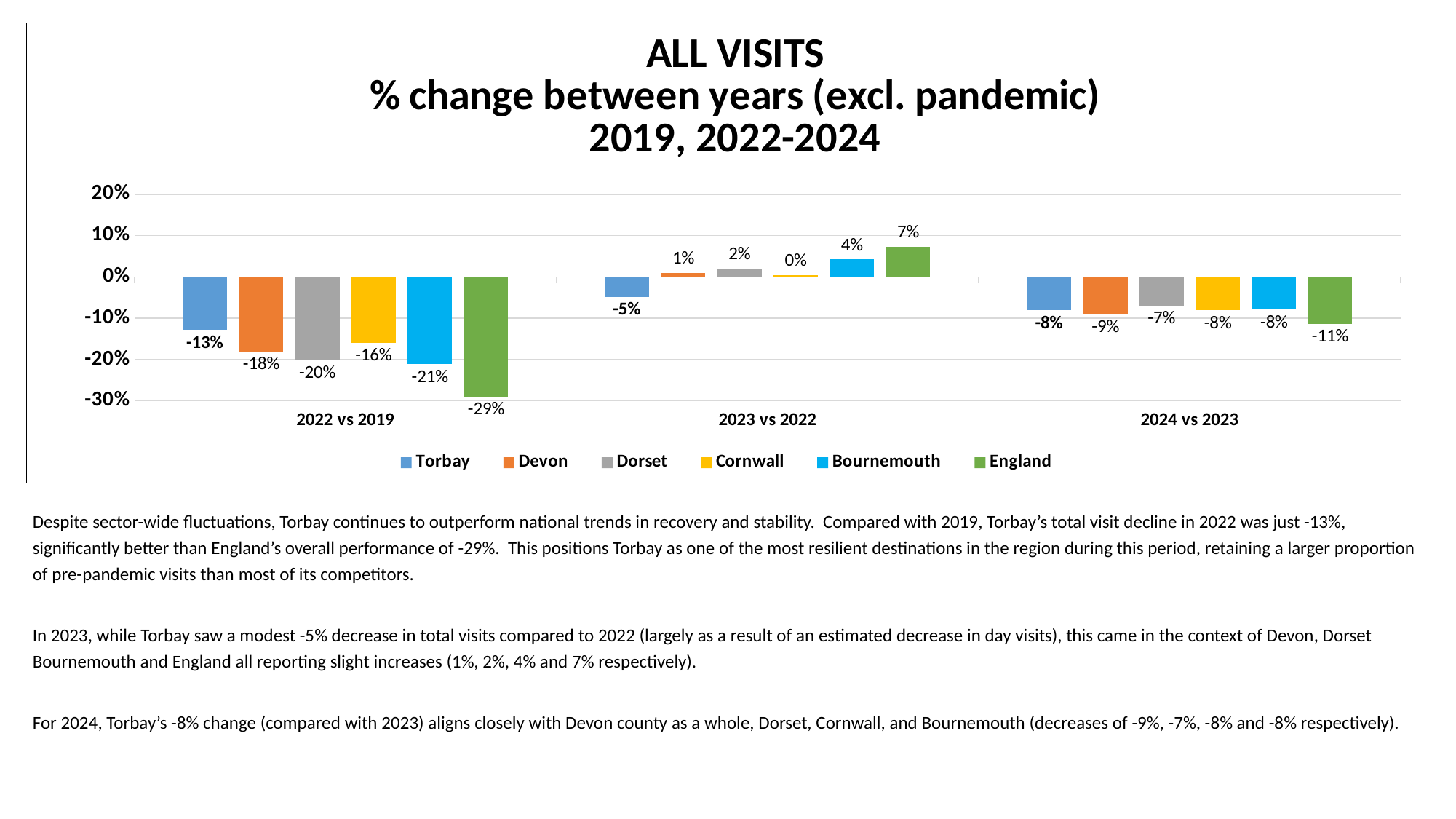
How many category groups are shown on the x axis? 3 What colour represents Bournemouth in the legend? Light blue Which series has the lowest value in the 2022 vs 2019 group? England What kind of chart is shown on the slide? Bar chart Which series has the highest value in the 2023 vs 2022 group? England In the 2024 vs 2023 group, which is larger, the value for Dorset or the value for England? Dorset How many series does the legend list? 6 What is the value for Dorset in the 2024 vs 2023 group? -7% What is the value for Cornwall in the 2023 vs 2022 group? 0% What is the difference between Torbay's and England's values in the 2022 vs 2019 group? 16 percentage points What is the value for Torbay in the 2023 vs 2022 group? -5% What is the value for England in the 2022 vs 2019 group? -29%